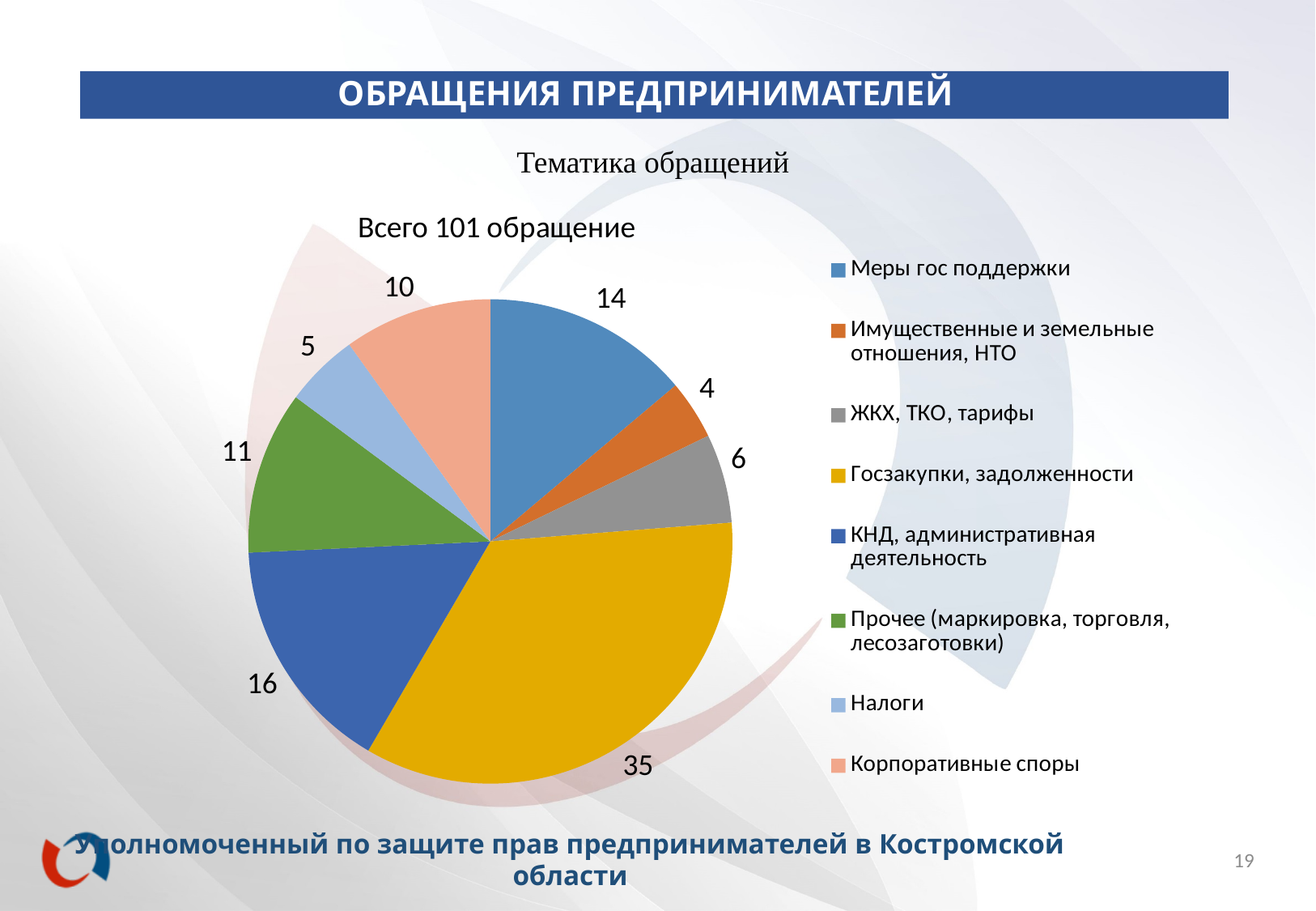
What is the difference between the values for Госзакупки, задолженности and КНД, административная деятельность? 19 How many categories does the pie chart have? 8 What is the value for Налоги? 5 Which is larger: Прочее (маркировка, торговля, лесозаготовки) or Корпоративные споры? Прочее (маркировка, торговля, лесозаготовки) What colour is the slice for ЖКХ, ТКО, тарифы? Grey What type of chart is shown on the slide? Pie chart Which category has the largest slice of the pie? Госзакупки, задолженности What is the total number of обращения according to the chart title? 101 Which category has the smallest slice of the pie? Имущественные и земельные отношения, НТО What is the value for КНД, административная деятельность? 16 What is the value for Госзакупки, задолженности? 35 What is the value for Меры гос поддержки? 14